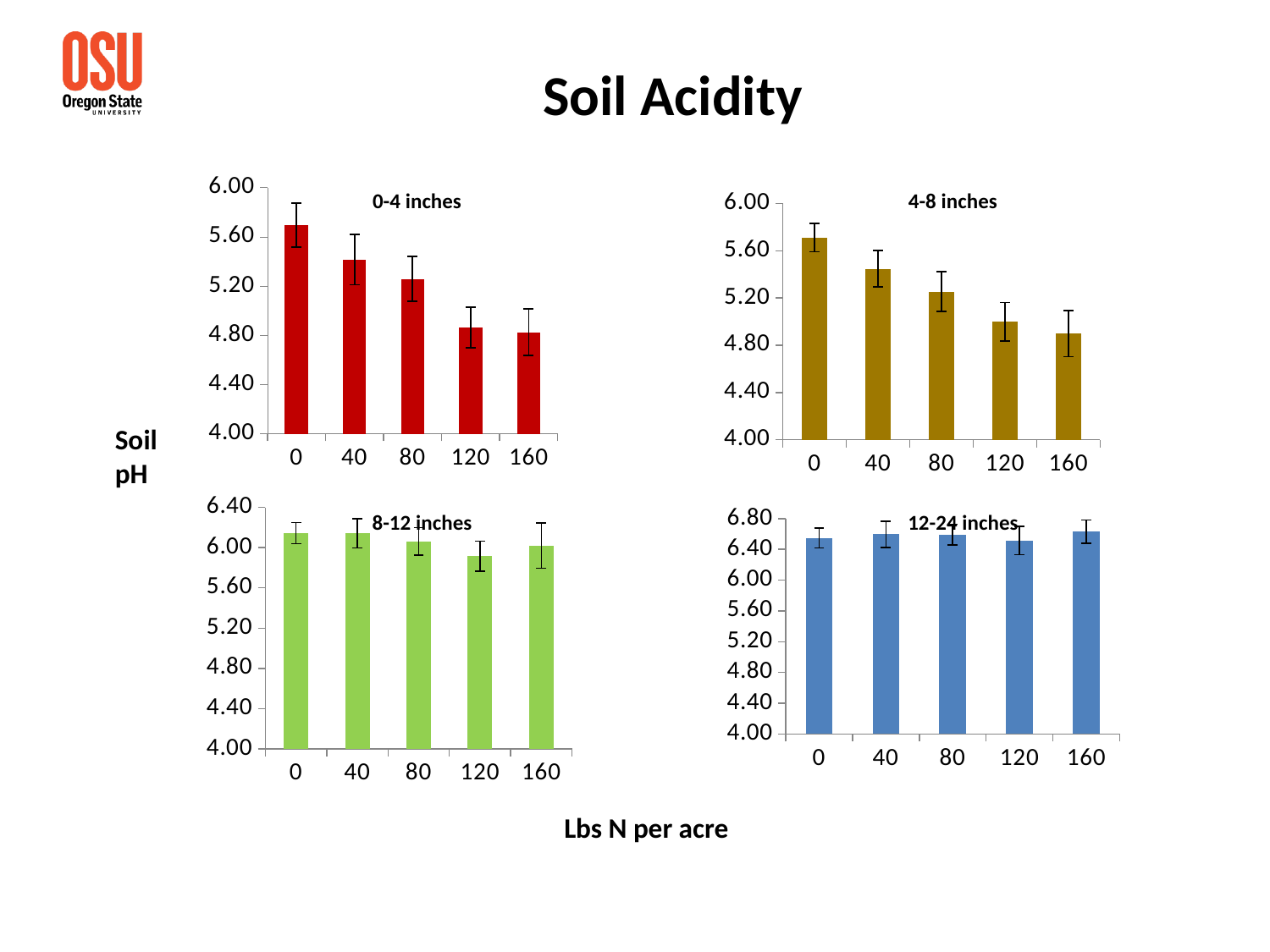
In the "8-12 inches" chart, is the value for 0 lbs N per acre greater or less than 6.00? greater In the "0-4 inches" chart, is the value for 0 lbs N per acre greater or less than 5.60? greater In the "4-8 inches" chart, which nitrogen rate has the highest soil pH? 0 What kind of chart is the "0-4 inches" chart? bar chart In the "0-4 inches" chart, which nitrogen rate has the highest soil pH? 0 How many bars are plotted in the "4-8 inches" chart? 5 In the "12-24 inches" chart, is the value for 160 lbs N per acre greater or less than 6.40? greater In the "0-4 inches" chart, which is larger, the value for 0 or the value for 160 lbs N per acre? 0 In the "0-4 inches" chart, do the soil pH values generally rise or fall as the nitrogen rate increases? fall What is the x-axis label shared by the charts on the slide? Lbs N per acre